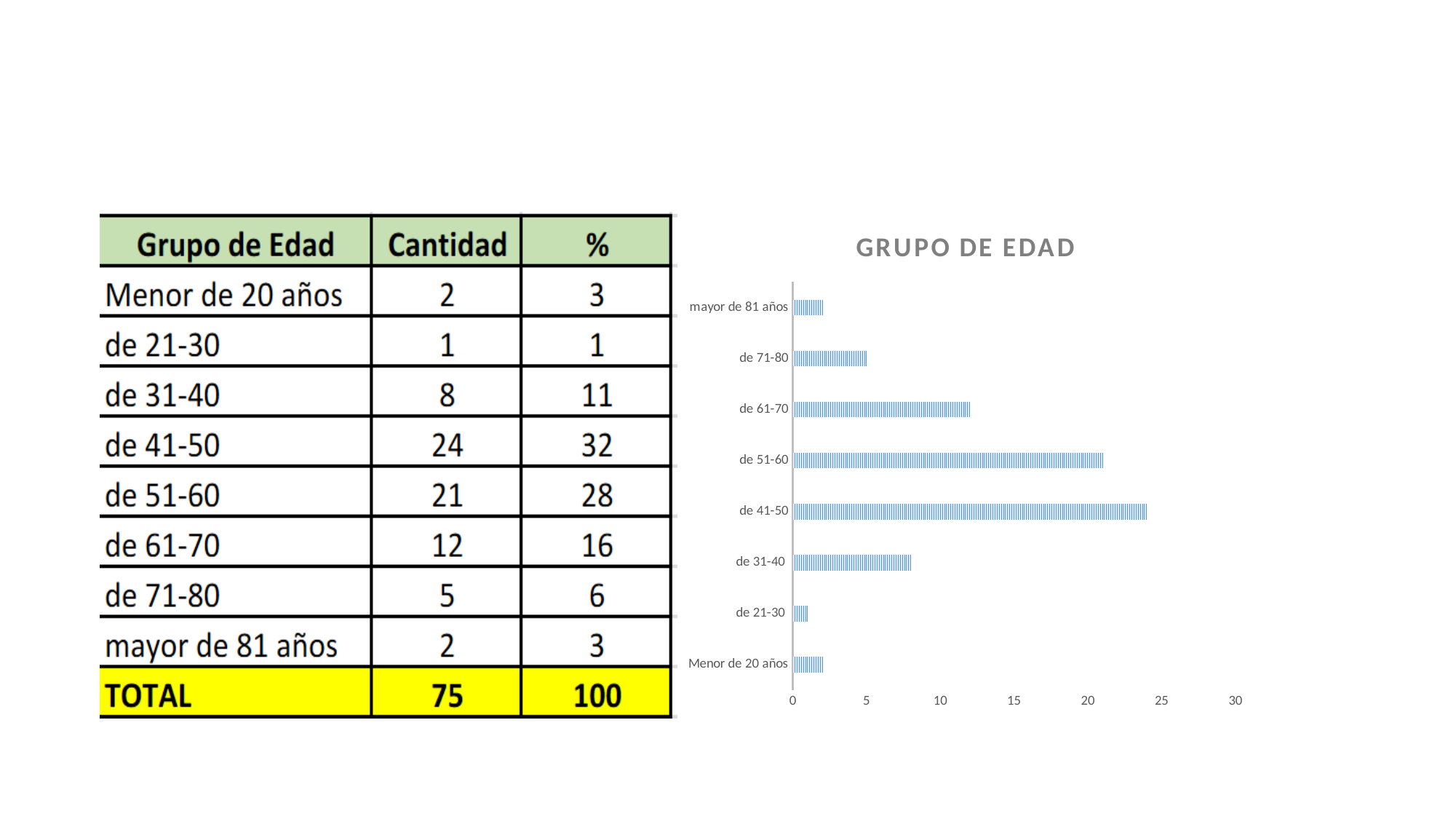
Which age group has the highest value in the chart? de 41-50 What is the difference between the values for de 41-50 and de 51-60? 3 Which age group has the lowest value in the chart? de 21-30 Is the value for de 61-70 greater or less than 10? greater What is the value for de 71-80 in the chart? 5 What is the value for de 41-50 in the chart? 24 Is the value for de 31-40 greater or less than 10? less How many age-group categories does the chart show? 8 Which is larger, the value for de 51-60 or the value for de 61-70? de 51-60 What kind of chart is shown on the slide? bar chart What is the value for de 51-60 in the chart? 21 What is the title of the chart? GRUPO DE EDAD